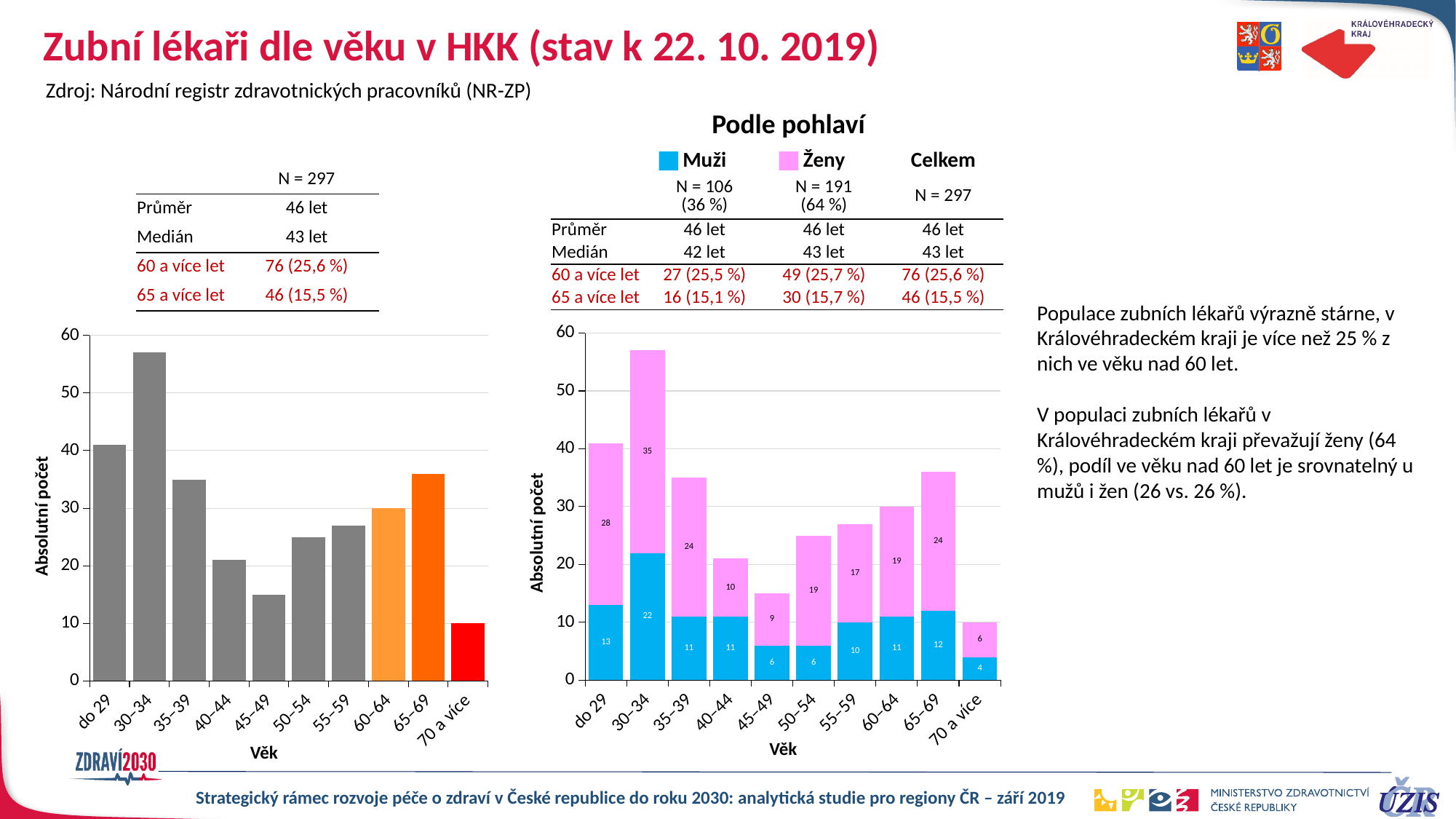
What kind of chart is the left chart? bar chart In the 'Podle pohlaví' chart, what is the value for Ženy in the 30–34 category? 35 In the 'Podle pohlaví' chart, what is the difference between Ženy and Muži in the 50–54 category? 13 In the left bar chart, which age category has the lowest value? 70 a více In the left bar chart, is the value for '45–49' greater or less than 20? less In the left bar chart, which age category has the highest value? 30–34 In the 'Podle pohlaví' chart, which is larger in the 40–44 category, Muži or Ženy? Muži In the 'Podle pohlaví' chart, what is the total of the stacked bar for the 'do 29' category? 41 How many age categories are shown on the x axis of the left bar chart? 10 In the 'Podle pohlaví' chart, what is the value for Muži in the 65–69 category? 12 How many series does the legend of the 'Podle pohlaví' chart list? 2